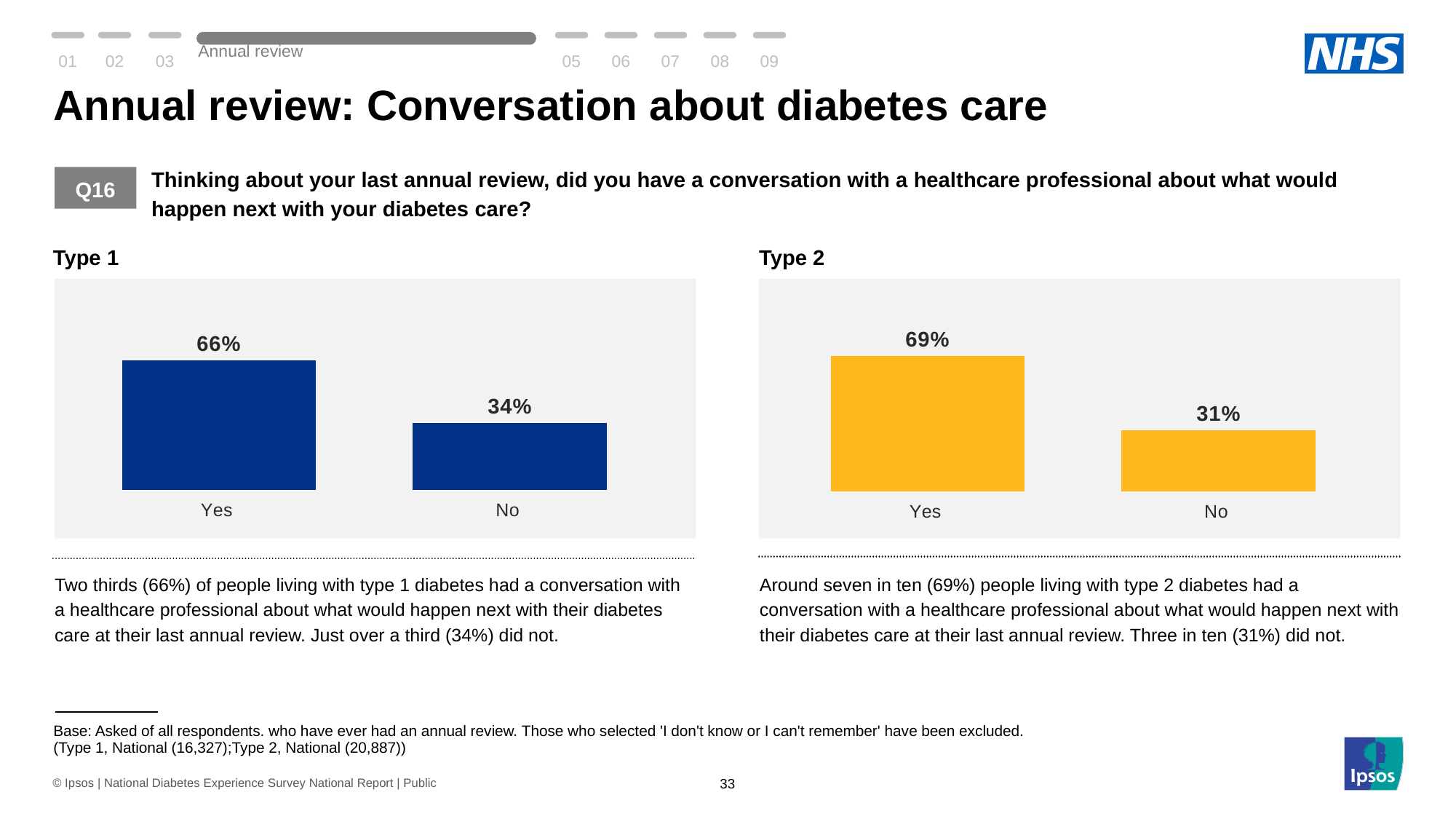
In the Type 2 chart, what is the difference between the Yes and No values? 38% In the Type 2 chart, what percentage of respondents answered Yes? 69% In the Type 1 chart, which response has the highest value? Yes What kind of chart is the Type 2 chart? Bar chart In the Type 1 chart, what is the difference between the Yes and No values? 32% What colour are the bars in the Type 2 chart? Yellow In the Type 1 chart, what percentage of respondents answered Yes? 66% Which is larger: the Yes value in the Type 1 chart or the Yes value in the Type 2 chart? Type 2 In the Type 2 chart, which response has the lowest value? No How many categories are shown in the Type 1 chart? 2 In the Type 2 chart, what percentage of respondents answered No? 31% In the Type 1 chart, what percentage of respondents answered No? 34%